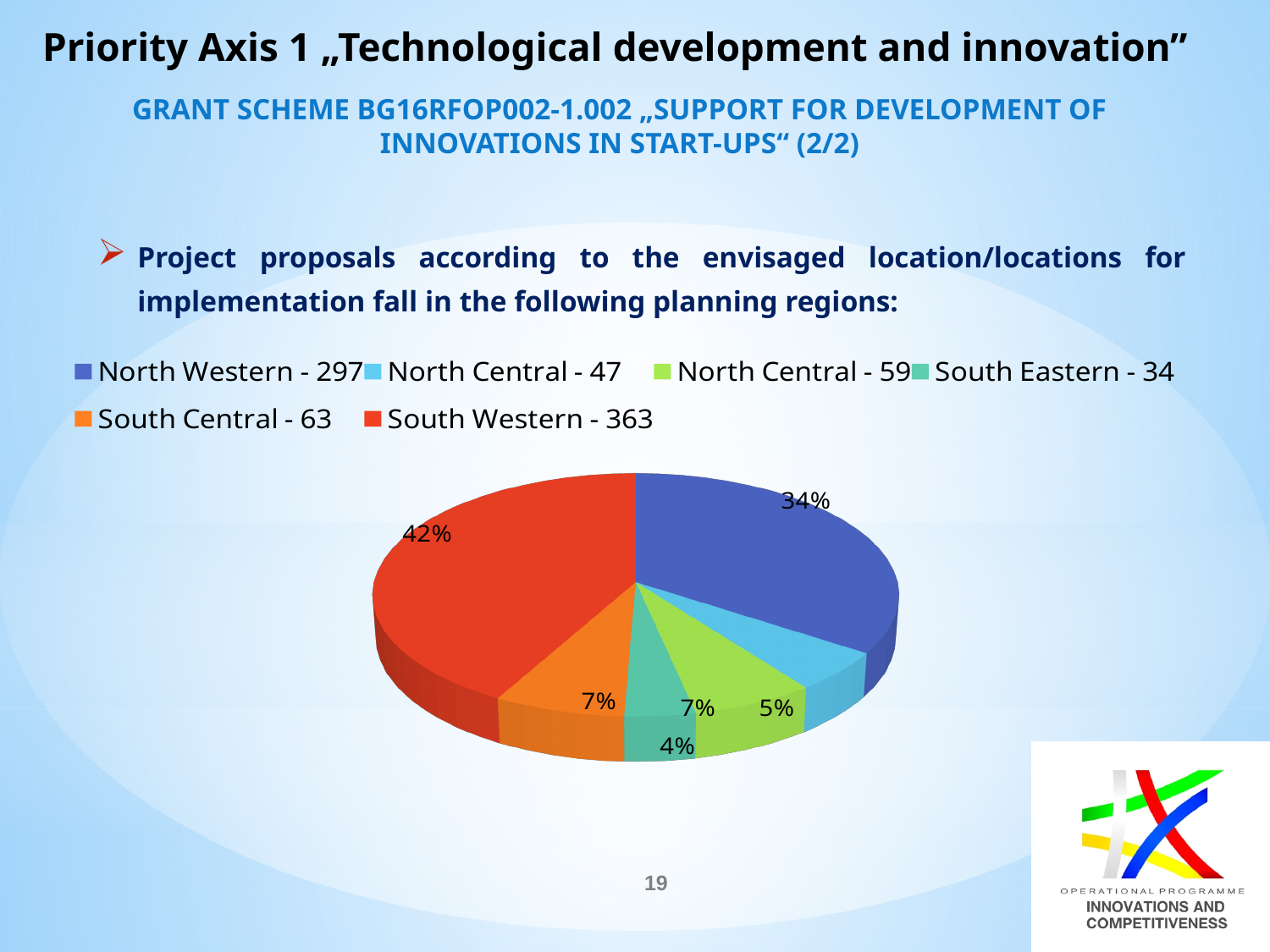
What kind of chart is shown on the slide? pie chart What is the difference between the number of project proposals in South Western and North Western? 66 What share of the pie does North Western account for? 34% According to the legend, how many project proposals fall in the South Western region? 363 Which region has the largest number of project proposals? South Western What colour is the South Western slice of the pie chart? red Which region has the smallest number of project proposals? South Eastern Which region has more project proposals, North Western or South Western? South Western What share of the pie does South Western account for? 42% According to the legend, how many project proposals fall in the South Eastern region? 34 How many planning regions (slices) does the pie chart show? 6 What share of the pie does South Eastern account for? 4%